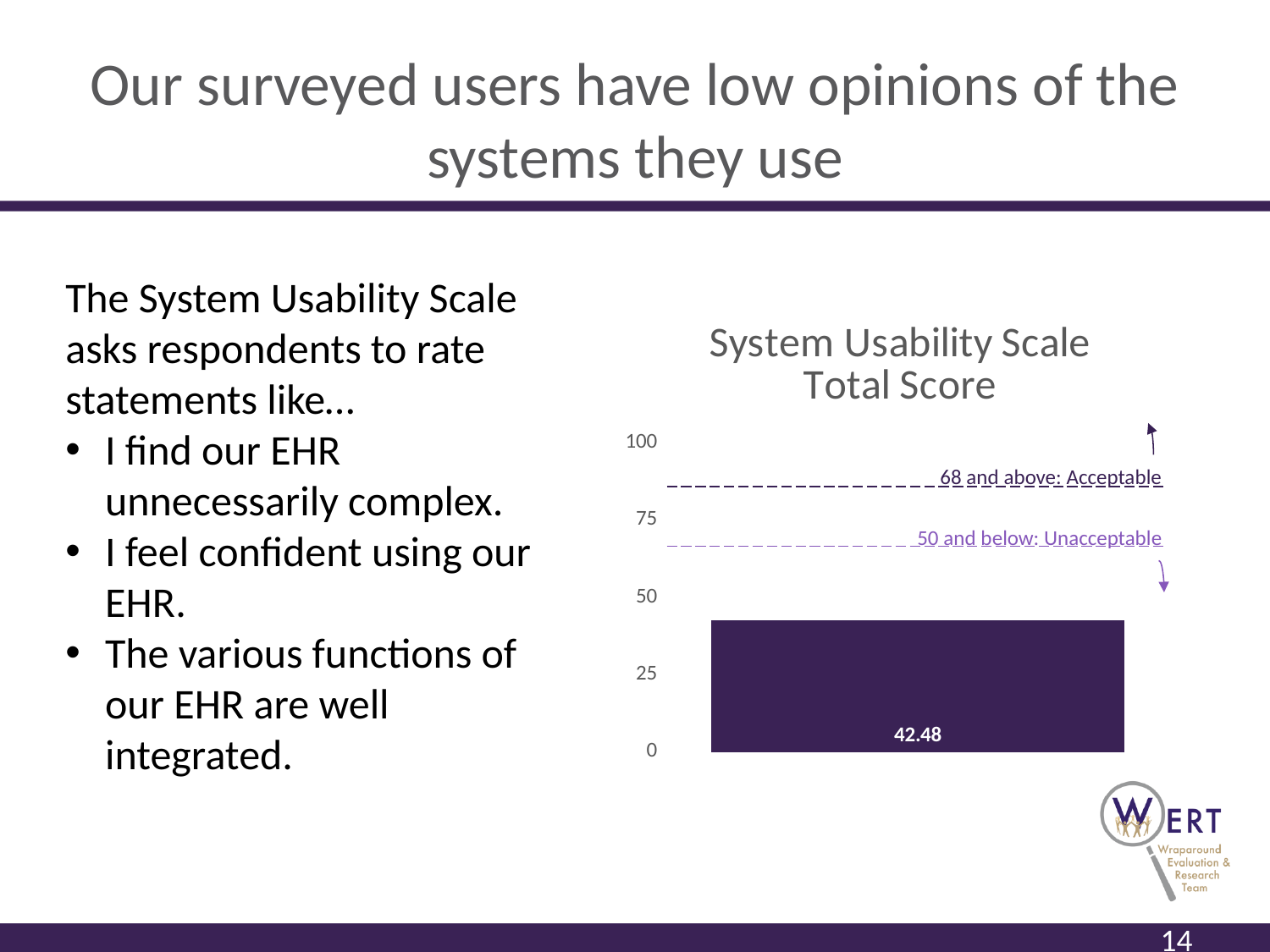
What kind of chart is used to show the System Usability Scale Total Score? bar chart What is the title of the chart on the slide? System Usability Scale Total Score How many bars are plotted in the System Usability Scale Total Score chart? 1 According to the annotation on the chart, what score range is labelled 'Acceptable'? 68 and above Is the System Usability Scale Total Score greater or less than 25? greater Is the System Usability Scale Total Score greater or less than 50? less What is the value shown on the bar in the System Usability Scale Total Score chart? 42.48 What is the highest value shown on the vertical axis of the chart? 100